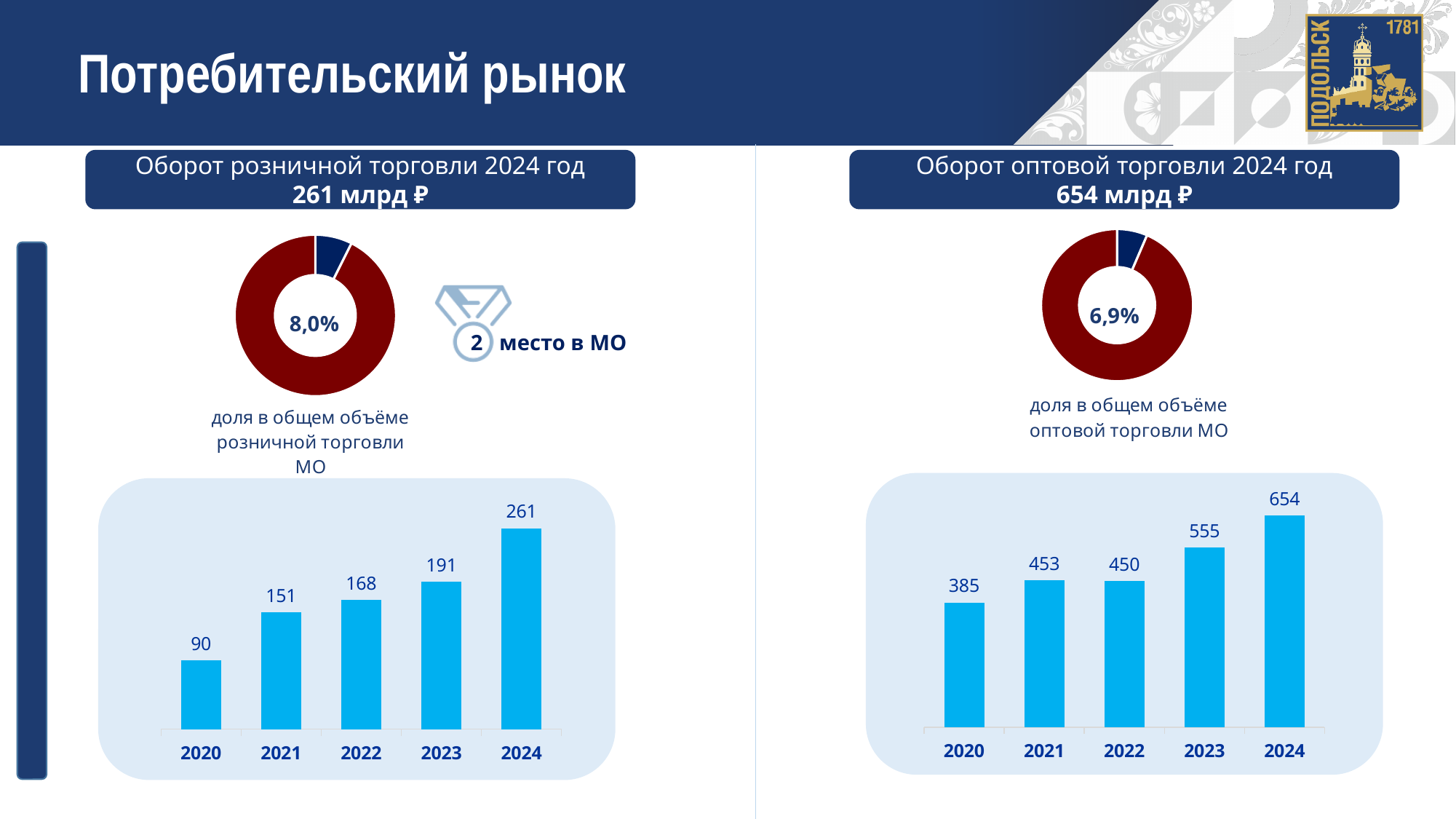
In the retail trade bar chart on the left, which year has the highest value? 2024 In the retail trade bar chart on the left, what is the difference between the 2024 and 2020 values? 171 In the wholesale trade bar chart on the right, which year has the lowest value? 2020 What share is shown in the donut chart on the right (share in total wholesale trade of MO)? 6,9% In the wholesale trade bar chart on the right, what is the value for 2020? 385 In the retail trade bar chart on the left, do the values rise or fall from 2020 to 2024? rise How many years are shown in the wholesale trade bar chart on the right? 5 In the retail trade bar chart on the left, what is the value for 2022? 168 In the wholesale trade bar chart on the right, which is larger, the value for 2021 or the value for 2022? 2021 What share is shown in the donut chart on the left (share in total retail trade of MO)? 8,0% In the wholesale trade bar chart on the right, what is the difference between the 2023 and 2022 values? 105 What type of chart is used to show the yearly retail trade turnover on the left? bar chart